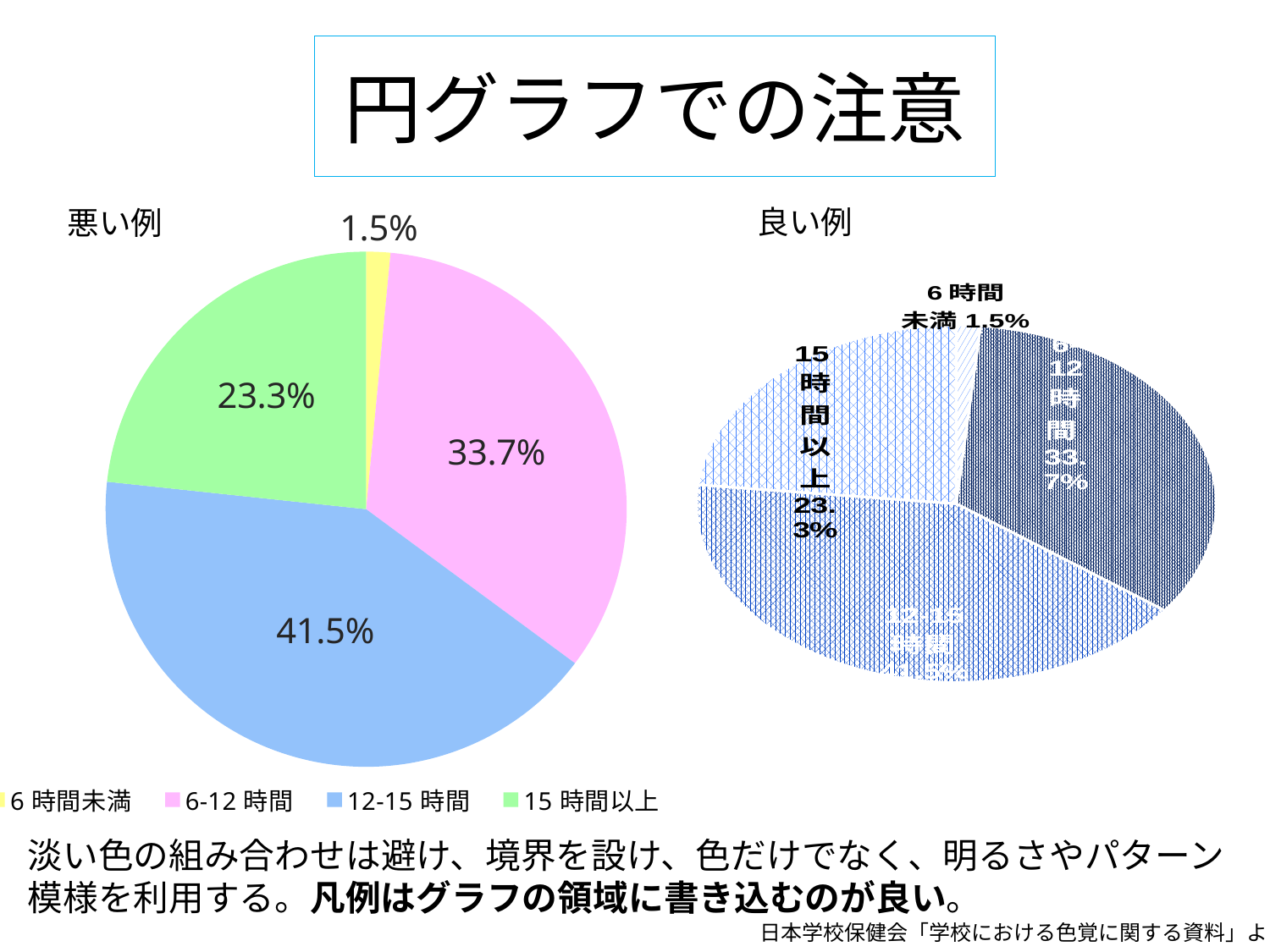
In the 悪い例 chart, what is the difference between the 12-15 時間 slice and the 6-12 時間 slice? 7.8% In the 悪い例 chart, which category has the largest slice? 12-15 時間 In the 良い例 chart, what is the value labelled for 15 時間以上? 23.3% How many categories does the legend of the 悪い例 chart list? 4 In the 悪い例 chart, what is the value for 6 時間未満? 1.5% In the 悪い例 chart, which is larger, the 6-12 時間 slice or the 15 時間以上 slice? 6-12 時間 In the 悪い例 chart, what colour is the 15 時間以上 slice? Green In the 悪い例 chart, what is the value for 12-15 時間? 41.5% In the 悪い例 chart, what is the value for 6-12 時間? 33.7% In the 悪い例 chart, what is the value for 15 時間以上? 23.3% What kind of chart is the 良い例 chart? Pie chart In the 悪い例 chart, which category has the smallest slice? 6 時間未満